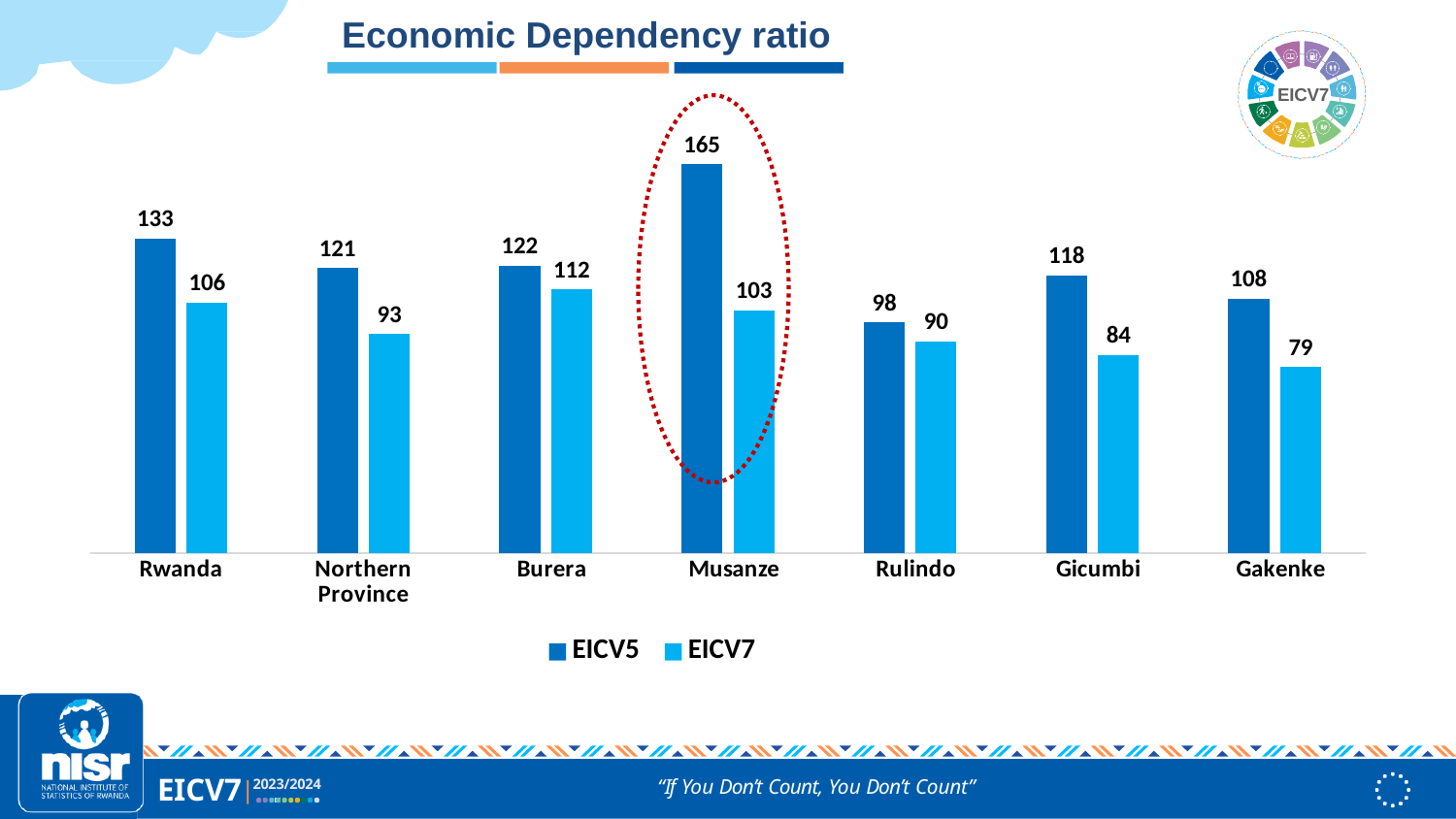
How many categories are shown on the x axis? 7 What is the EICV7 economic dependency ratio for Musanze? 103 What is the EICV5 economic dependency ratio for Rwanda? 133 Which is larger, the EICV7 value for Burera or the EICV7 value for Rulindo? Burera How many series does the legend list? 2 What is the difference between the EICV5 and EICV7 values for Musanze? 62 What kind of chart is shown on the slide? Bar chart What is the EICV7 value for Gakenke? 79 What is the difference between the EICV5 values for Rwanda and Northern Province? 12 Which category has the highest EICV5 value? Musanze What is the title of the chart? Economic Dependency ratio Which category has the lowest EICV7 value? Gakenke